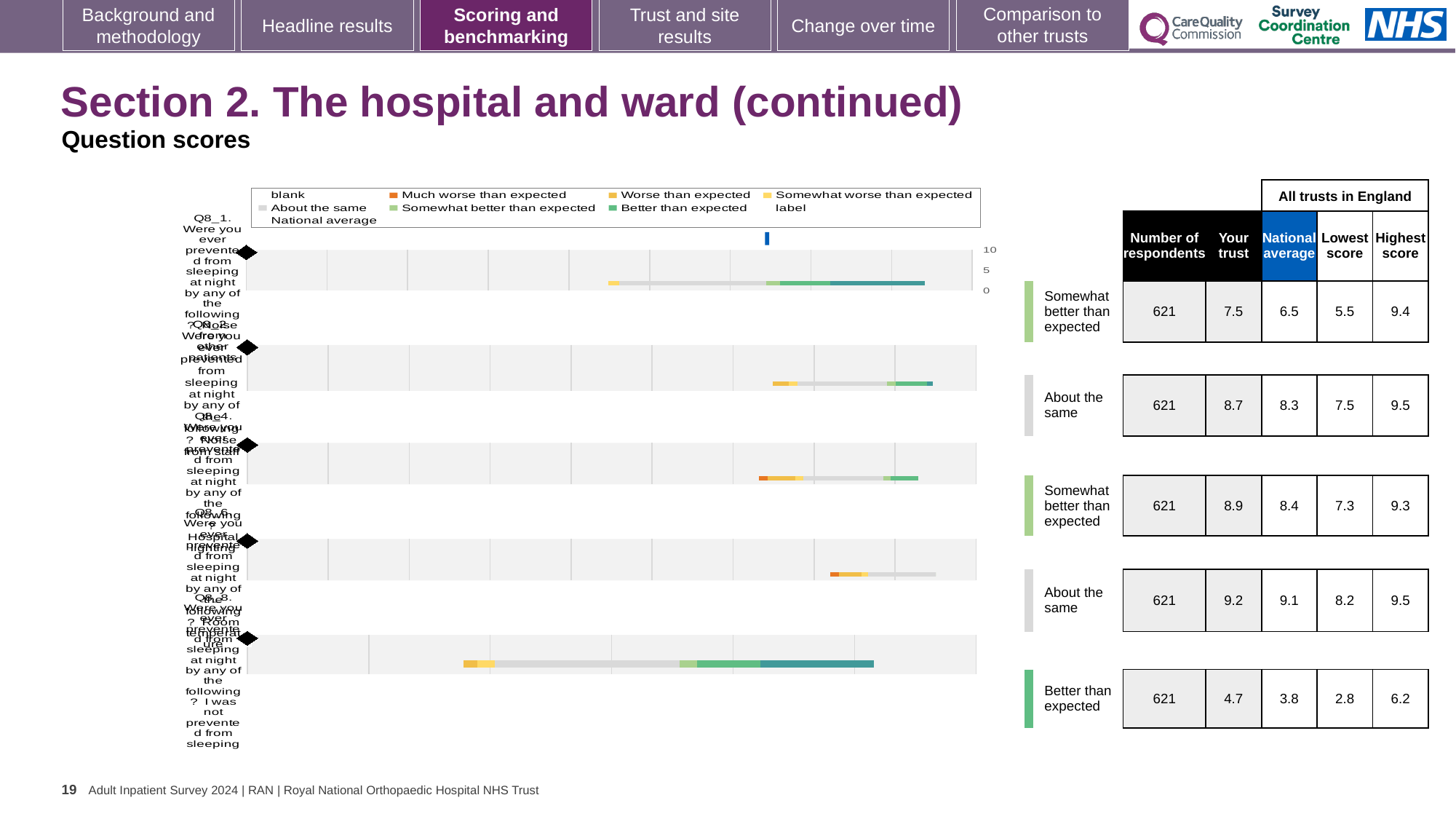
How many respondents are listed for each question in the table beside the chart? 621 What type of chart is shown on the slide? bar chart In the table beside the chart, what is the 'Your trust' score for the first row (Q8_1)? 7.5 In the table beside the chart, what is the 'Your trust' score for the last row (Q8_8)? 4.7 What colour does the legend use for 'Much worse than expected'? orange Which is larger for the first row (Q8_1): the 'Your trust' score or the national average? Your trust In the table beside the chart, what is the highest score for the third row (Q8_4)? 9.3 Which row has the lowest 'Your trust' score in the table beside the chart? Q8_8 (last row) In the table beside the chart, what is the lowest score for the fourth row (Q8_6)? 8.2 In the table beside the chart, what is the national average for the second row (Q8_2)? 8.3 How many question rows (bars) does the chart show? 5 What is the difference between the 'Your trust' score and the national average for the last row (Q8_8)? 0.9